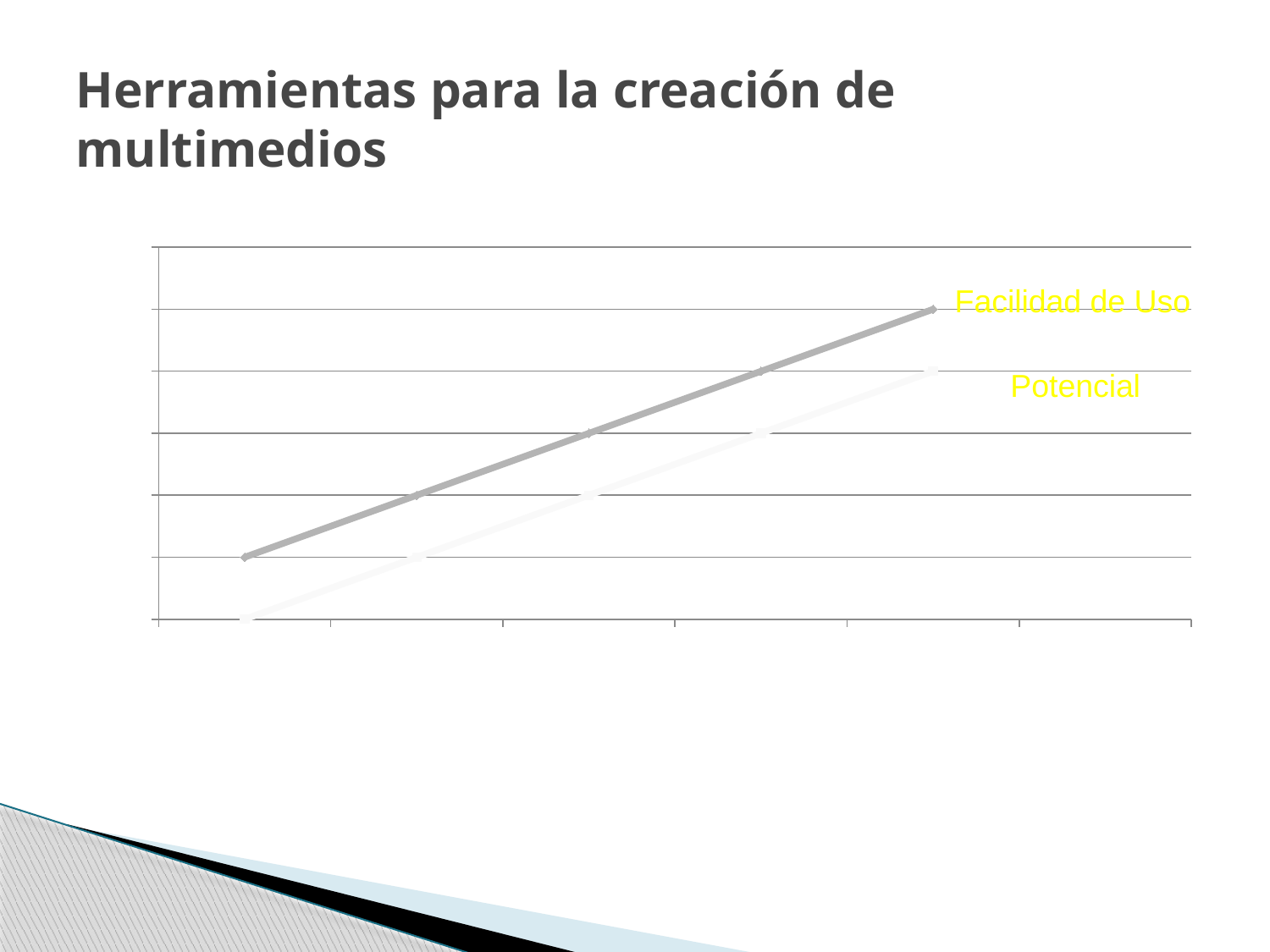
Do the values of the Facilidad de Uso series rise or fall from left to right? rise Which series is drawn with the darker gray line? Facilidad de Uso What are the names of the two series plotted on the chart? Facilidad de Uso and Potencial What kind of chart is shown on the slide? line chart Do the values of the Potencial series rise or fall from left to right? rise Which series starts at the lowest point on the chart? Potencial How many data points does each line on the chart have? 5 How many series are plotted on the chart? 2 Which series is plotted higher on the chart, Facilidad de Uso or Potencial? Facilidad de Uso Which series has the lower line on the chart? Potencial